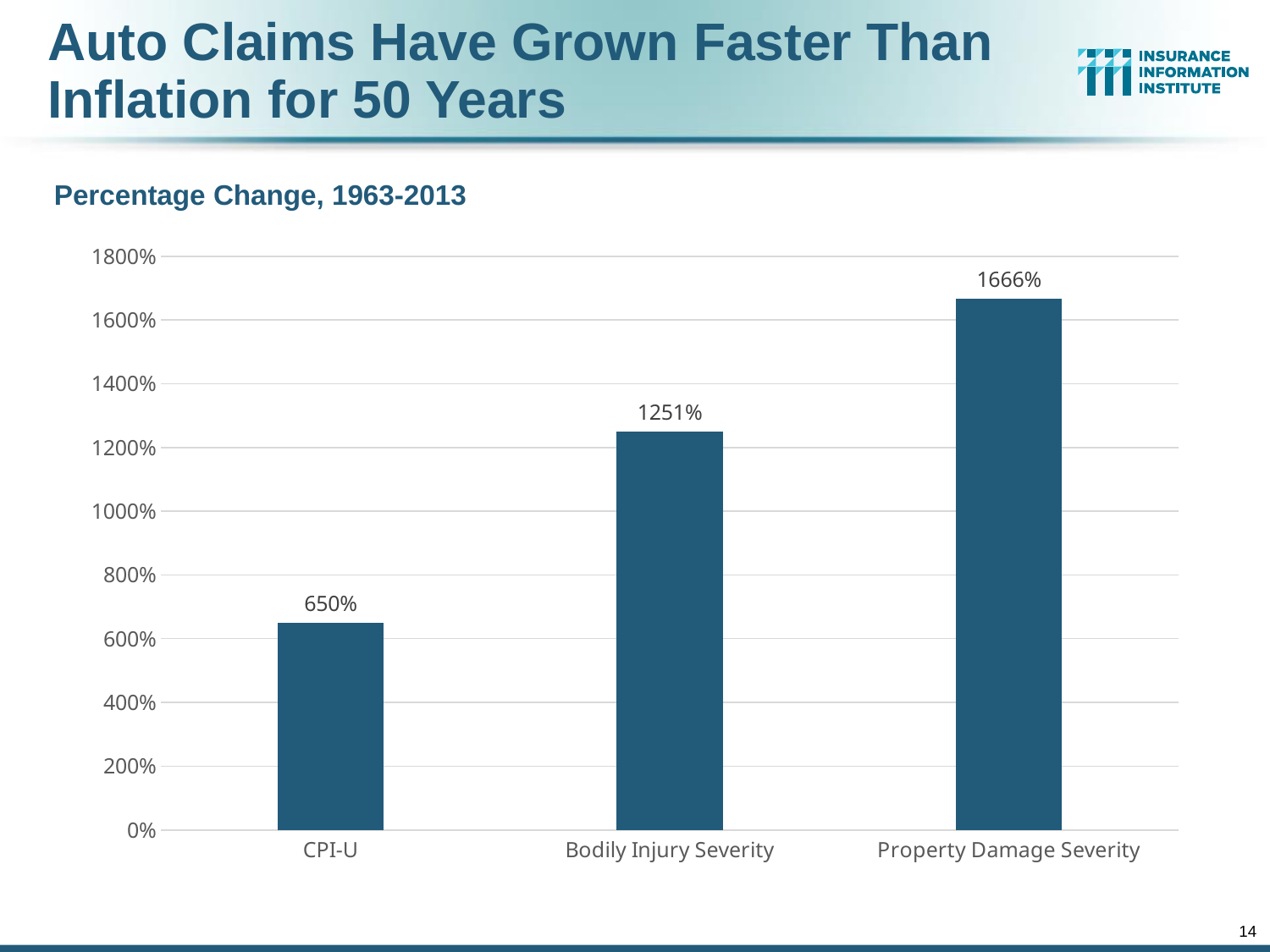
What is the subtitle of the chart? Percentage Change, 1963-2013 How many categories are shown in the chart? 3 Is the value for Bodily Injury Severity greater or less than 1200%? greater What is the percentage change for CPI-U? 650% Which is larger, the percentage change for Bodily Injury Severity or for Property Damage Severity? Property Damage Severity What is the difference between the percentage change for Bodily Injury Severity and CPI-U? 601% Which category has the lowest percentage change? CPI-U Which category has the highest percentage change? Property Damage Severity What is the percentage change for Property Damage Severity? 1666% What is the percentage change for Bodily Injury Severity? 1251% What kind of chart is shown on the slide? Bar chart What is the difference between the percentage change for Property Damage Severity and CPI-U? 1016%